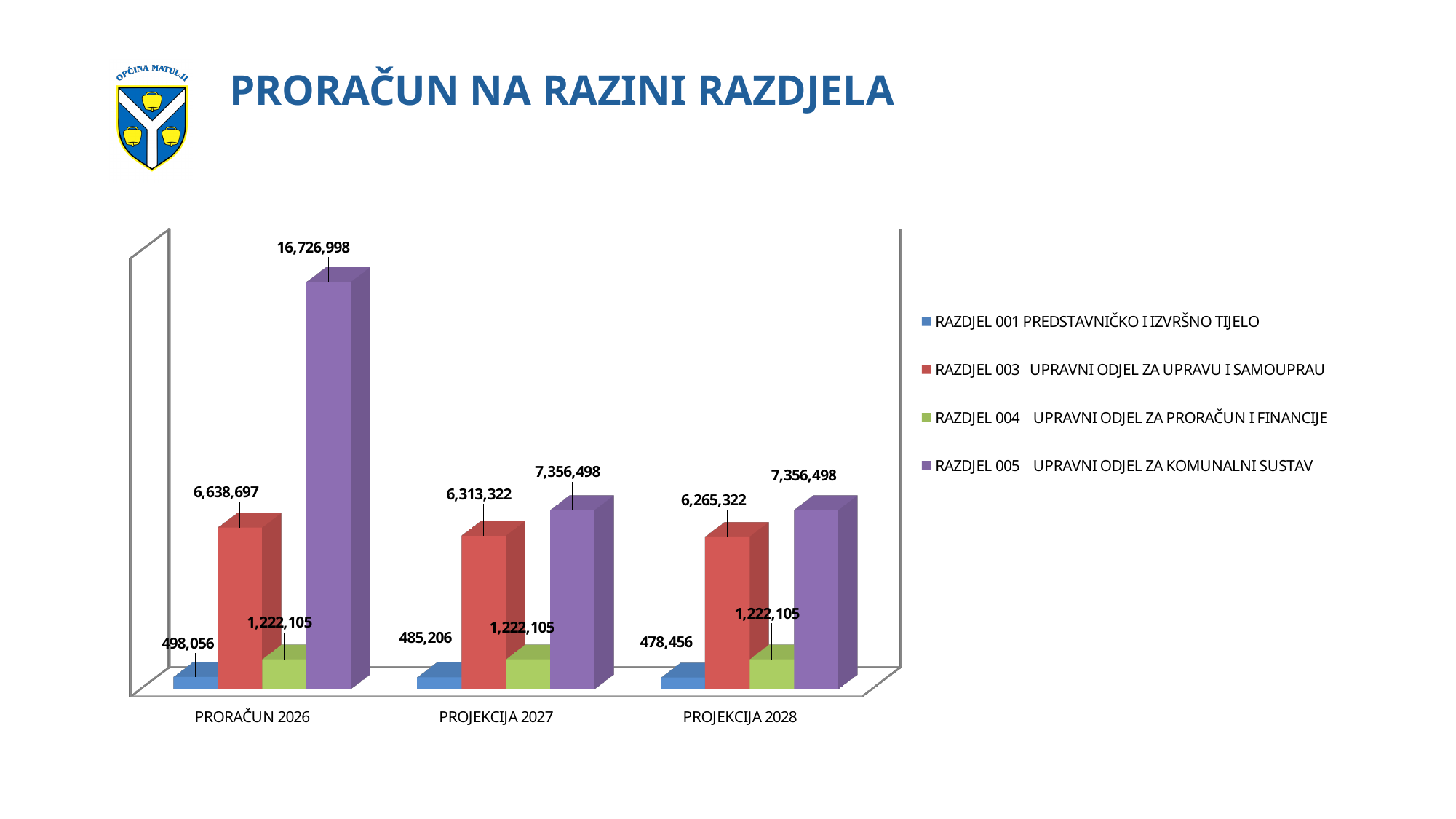
What is the value for RAZDJEL 001 PREDSTAVNIČKO I IZVRŠNO TIJELO in PROJEKCIJA 2028? 478,456 What kind of chart is shown on the slide? Bar chart How many categories are shown on the x axis? 3 What is the value for RAZDJEL 005 UPRAVNI ODJEL ZA KOMUNALNI SUSTAV in PRORAČUN 2026? 16,726,998 What is the value for RAZDJEL 003 UPRAVNI ODJEL ZA UPRAVU I SAMOUPRAU in PROJEKCIJA 2027? 6,313,322 Which is larger: the RAZDJEL 003 value in PRORAČUN 2026 or in PROJEKCIJA 2028? PRORAČUN 2026 How many series does the legend list? 4 Which series has the lowest value in PROJEKCIJA 2027? RAZDJEL 001 PREDSTAVNIČKO I IZVRŠNO TIJELO Which series has the highest value in PRORAČUN 2026? RAZDJEL 005 UPRAVNI ODJEL ZA KOMUNALNI SUSTAV What is the difference between the RAZDJEL 003 value in PRORAČUN 2026 and in PROJEKCIJA 2027? 325,375 What is the value for RAZDJEL 004 UPRAVNI ODJEL ZA PRORAČUN I FINANCIJE in PROJEKCIJA 2028? 1,222,105 What is the difference between the RAZDJEL 005 value in PRORAČUN 2026 and in PROJEKCIJA 2027? 9,370,500